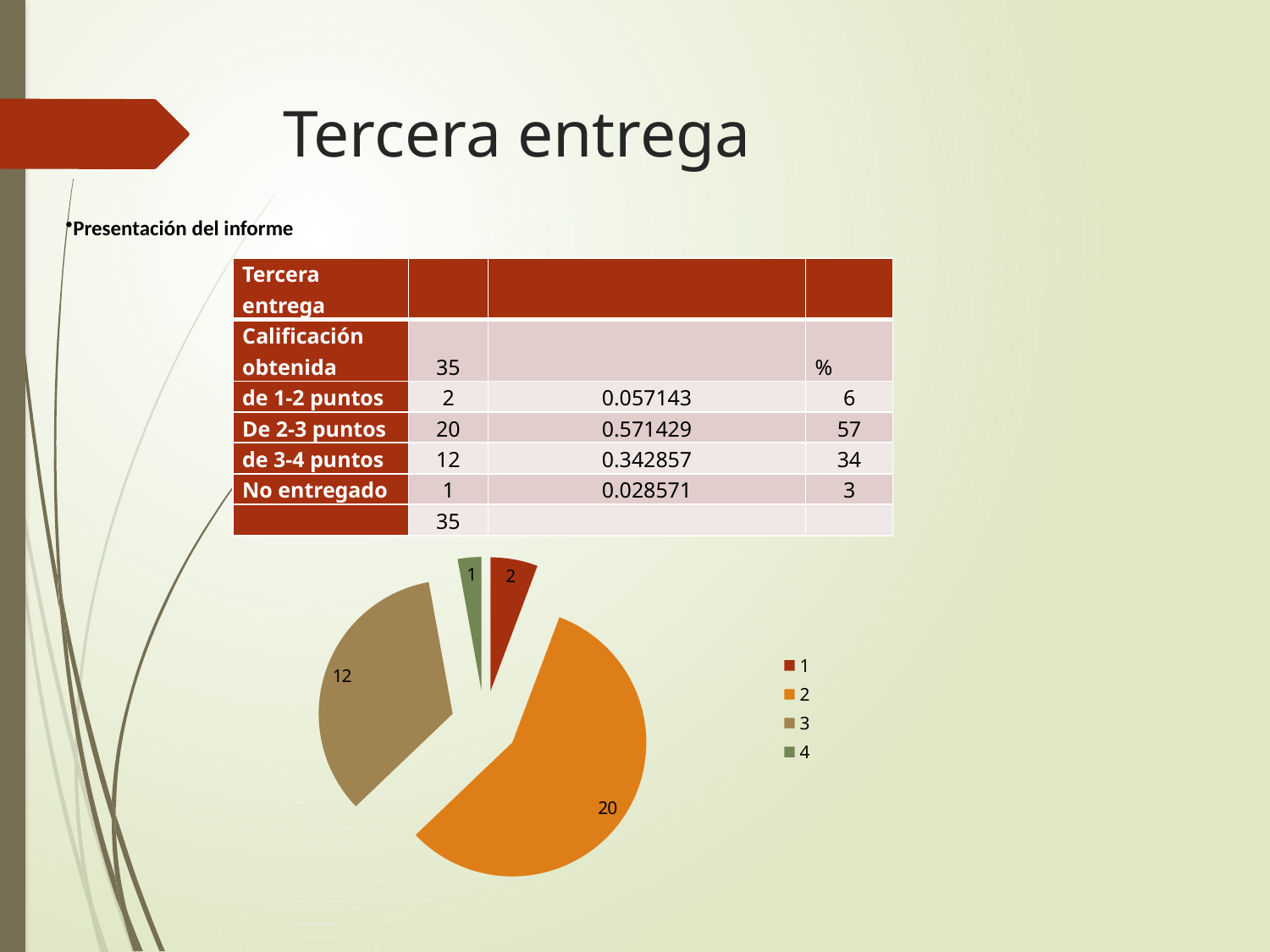
What is the value of the slice labelled 4 in the legend (the green slice)? 1 Which slice is larger, slice 1 or slice 3? 3 What type of chart is shown on the slide? pie chart What is the difference between the values of slice 2 and slice 3? 8 Which legend category has the smallest slice in the pie chart? 4 How many entries does the legend of the pie chart list? 4 Which legend category has the largest slice in the pie chart? 2 What is the value of the slice labelled 2 in the legend (the orange slice)? 20 What is the total of all the slice values in the pie chart? 35 What is the value of the slice labelled 1 in the legend (the dark red slice)? 2 How many slices does the pie chart have? 4 What is the value of the slice labelled 3 in the legend (the brown slice)? 12